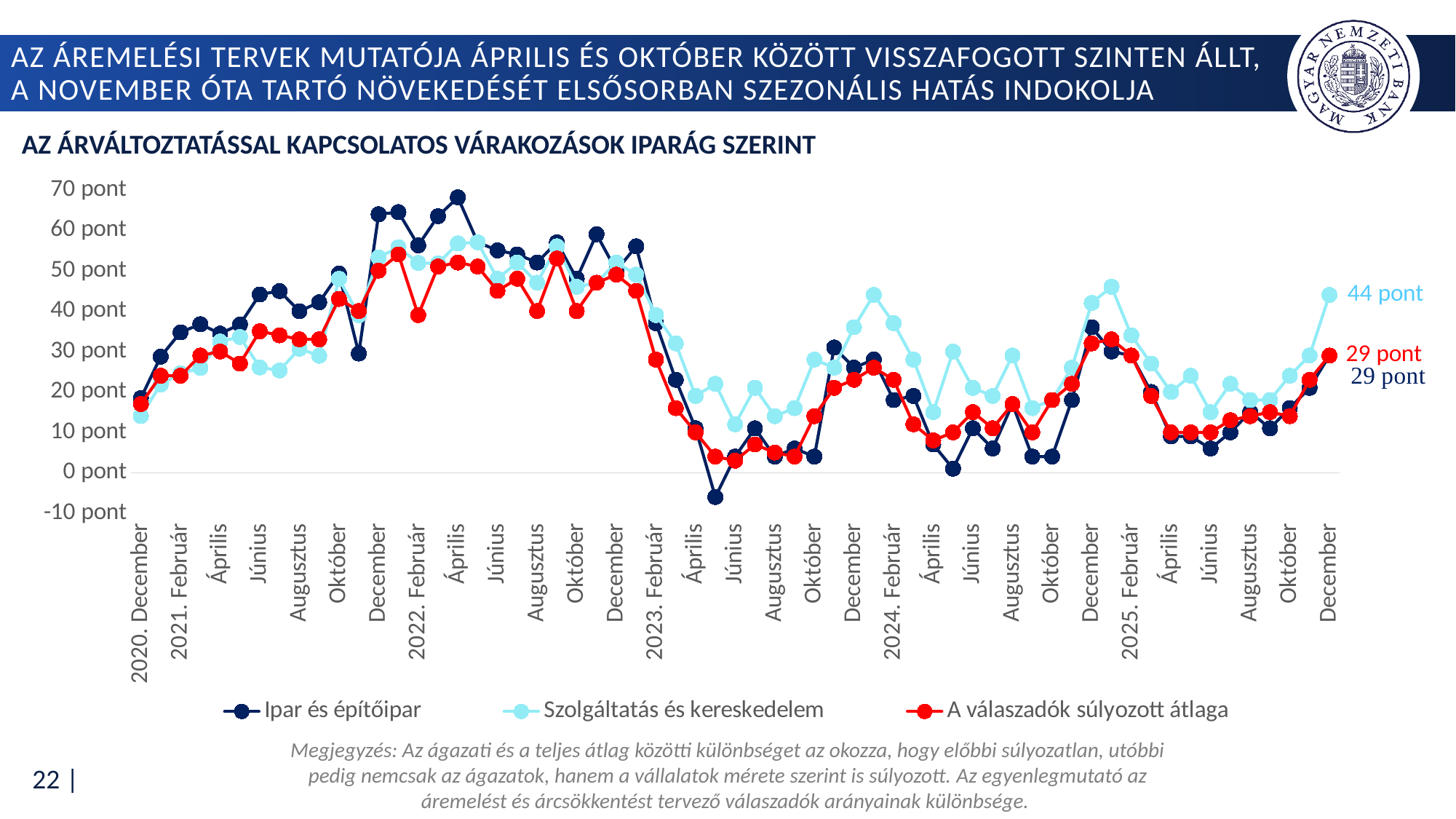
What kind of chart is shown on the slide? line chart What is the value for A válaszadók súlyozott átlaga in December 2025? 29 pont Is the value for Ipar és építőipar in April 2022 greater or less than 60 pont? greater How many series does the legend list? 3 What is the difference between the December 2025 values of Szolgáltatás és kereskedelem and Ipar és építőipar? 15 pont Which series has the highest value in December 2025? Szolgáltatás és kereskedelem What is the value for Szolgáltatás és kereskedelem in December 2025? 44 pont What is the value for Ipar és építőipar in December 2025? 29 pont What is the title of the chart? AZ ÁRVÁLTOZTATÁSSAL KAPCSOLATOS VÁRAKOZÁSOK IPARÁG SZERINT Is the lowest value of Ipar és építőipar on the chart greater or less than 0 pont? less In December 2025, which is larger: the value for Szolgáltatás és kereskedelem or the value for A válaszadók súlyozott átlaga? Szolgáltatás és kereskedelem Does the value for Szolgáltatás és kereskedelem rise or fall between October 2025 and December 2025? rise